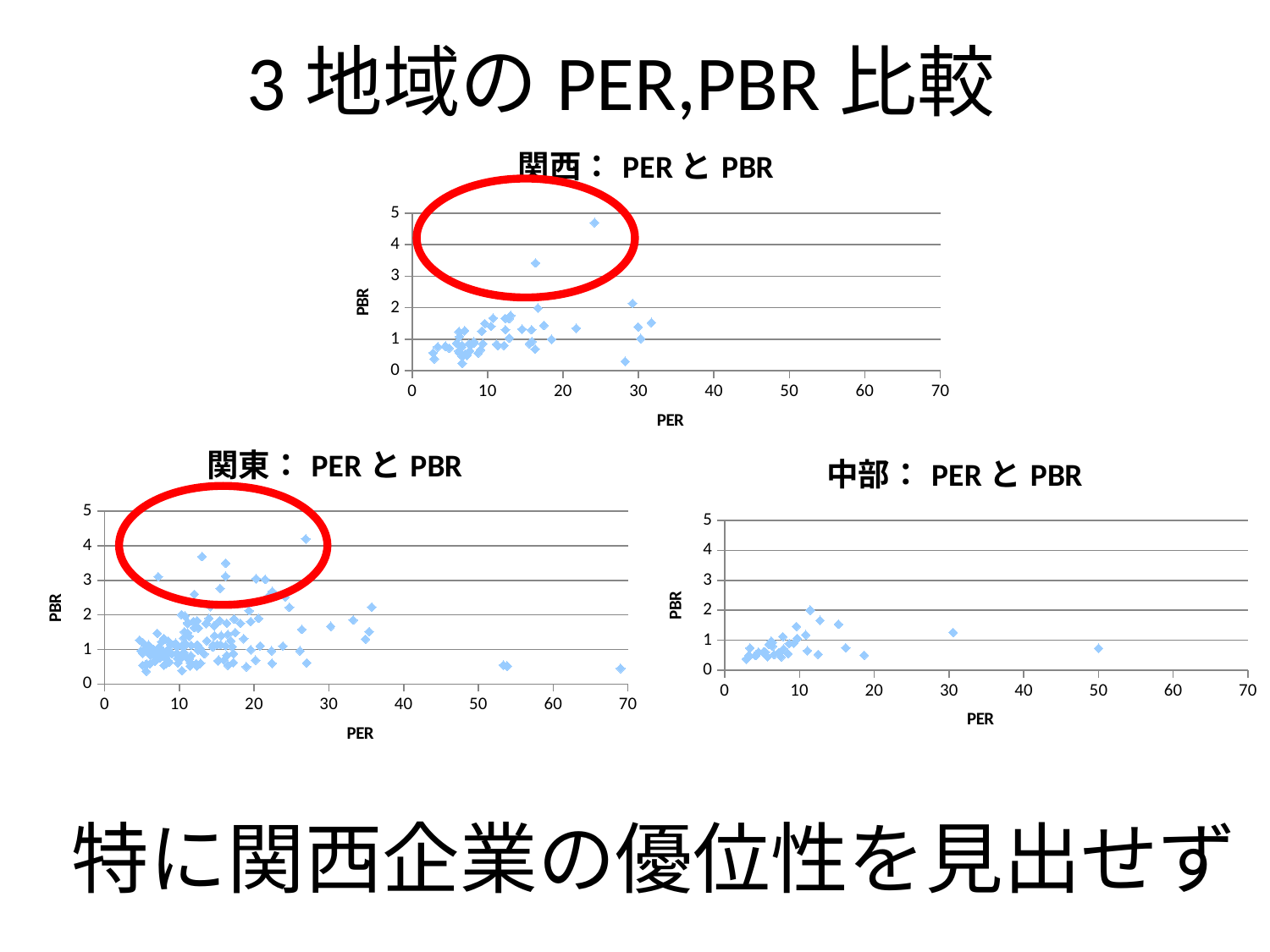
How many charts are shown on the slide? 3 In the 関東： PER と PBR chart, is the PBR value of the point with the largest PER (near 70) greater or less than 1? less In the 中部： PER と PBR chart, what is the label of the vertical axis? PBR In the 関西： PER と PBR chart, what is the label of the horizontal axis? PER What is the maximum value shown on the PER axis of the 関東： PER と PBR chart? 70 What kind of chart is the 関西： PER と PBR chart? scatter chart In the 関西： PER と PBR chart, is the PBR value of the point at PER around 16 inside the red circle greater or less than 3? greater In the 中部： PER と PBR chart, is any point plotted with a PBR greater than 3? no What is the maximum value shown on the PBR axis of the 中部： PER と PBR chart? 5 Which chart has the most points plotted with PER greater than 40: 関西, 関東, or 中部? 関東